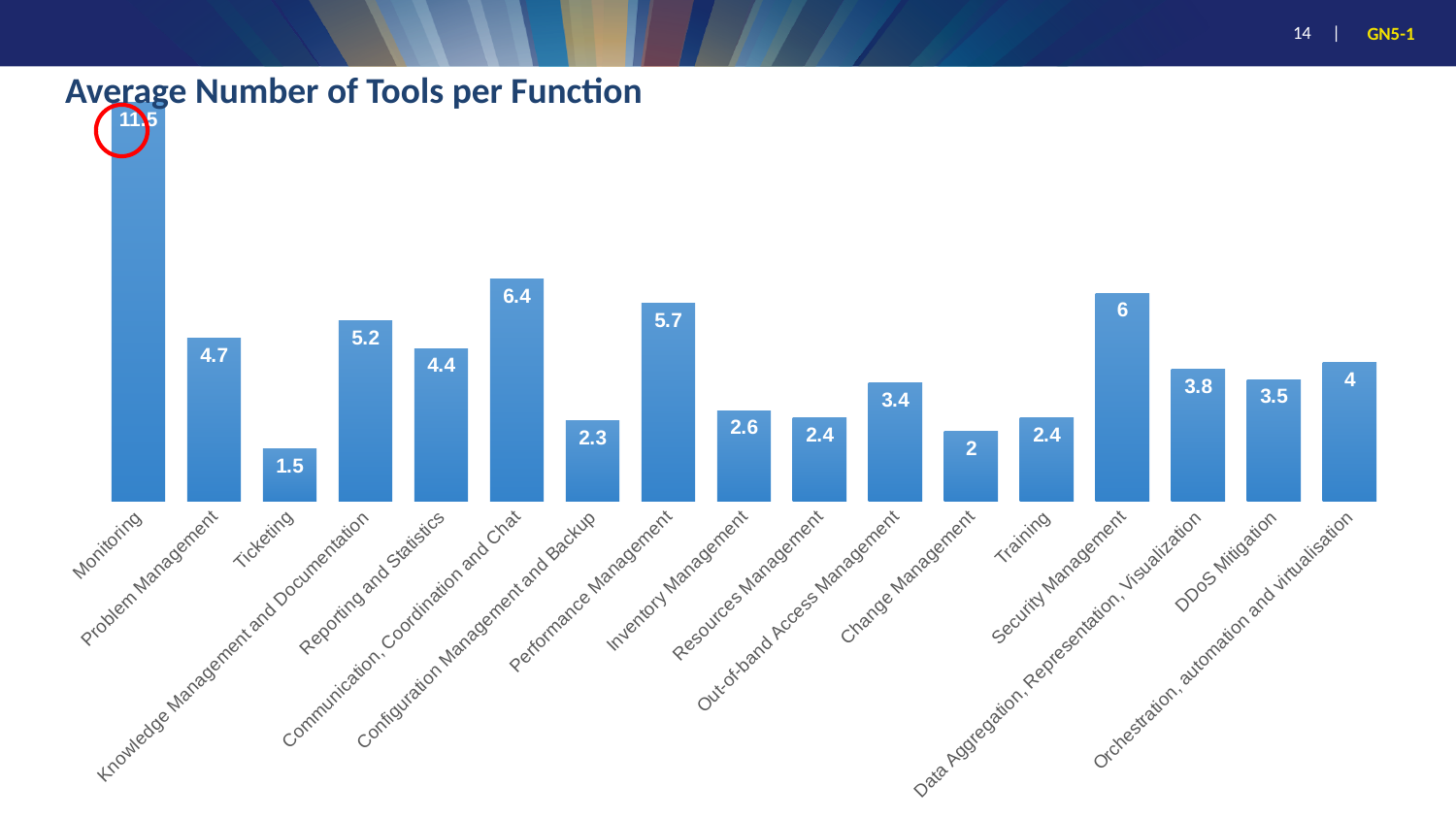
What kind of chart is shown on the slide? bar chart Which has a larger value, Knowledge Management and Documentation or Reporting and Statistics? Knowledge Management and Documentation Which function has the highest average number of tools? Monitoring What is the difference between the values for Performance Management and Inventory Management? 3.1 What is the title of the chart? Average Number of Tools per Function What is the difference between the values for Out-of-band Access Management and Change Management? 1.4 What is the value shown for DDoS Mitigation? 3.5 What is the value shown for Communication, Coordination and Chat? 6.4 How many functions are shown in the chart? 17 What is the value shown for Security Management? 6 Which function has the lowest average number of tools? Ticketing What is the average number of tools for Problem Management? 4.7